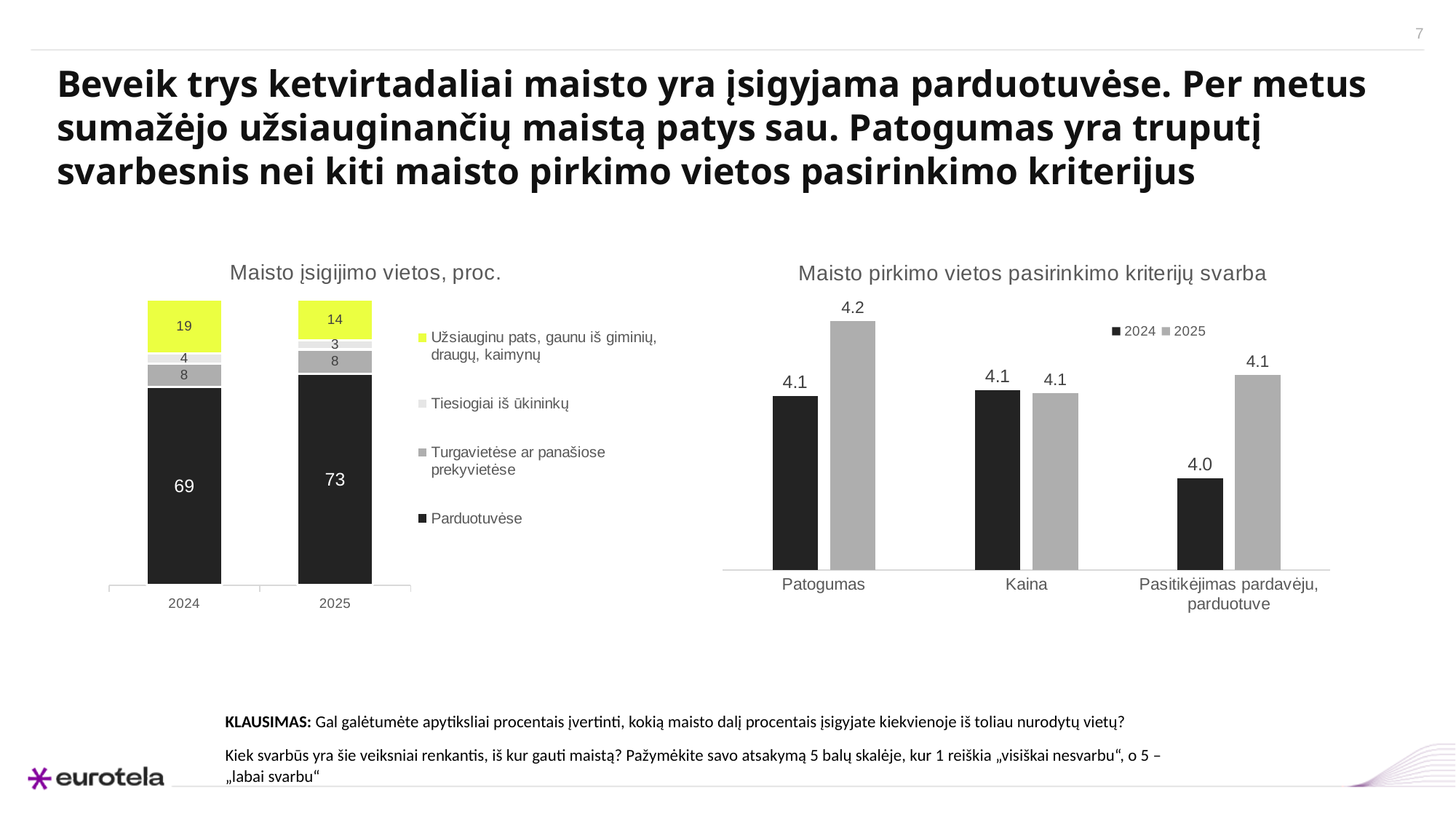
In the chart 'Maisto pirkimo vietos pasirinkimo kriterijų svarba', how many categories are shown on the x axis? 3 In the chart 'Maisto pirkimo vietos pasirinkimo kriterijų svarba', what is the 2024 value for 'Pasitikėjimas pardavėju, parduotuve'? 4.0 In the chart 'Maisto įsigijimo vietos, proc.', what is the value for 'Užsiauginu pats, gaunu iš giminių, draugų, kaimynų' in 2024? 19 In the chart 'Maisto įsigijimo vietos, proc.', which series has the largest value in 2025? Parduotuvėse In the chart 'Maisto įsigijimo vietos, proc.', what is the value for Parduotuvėse in 2025? 73 In the chart 'Maisto įsigijimo vietos, proc.', by how much did the Parduotuvėse value change from 2024 to 2025? 4 What kind of chart is 'Maisto įsigijimo vietos, proc.'? Stacked bar chart In the chart 'Maisto pirkimo vietos pasirinkimo kriterijų svarba', what is the 2025 value for Patogumas? 4.2 In the chart 'Maisto pirkimo vietos pasirinkimo kriterijų svarba', which is larger for Patogumas: the 2024 value or the 2025 value? 2025 In the chart 'Maisto pirkimo vietos pasirinkimo kriterijų svarba', which category has the lowest 2024 value? Pasitikėjimas pardavėju, parduotuve In the chart 'Maisto įsigijimo vietos, proc.', how many series does the legend list? 4 In the chart 'Maisto įsigijimo vietos, proc.', what is the total of the stacked bar for 2024? 100